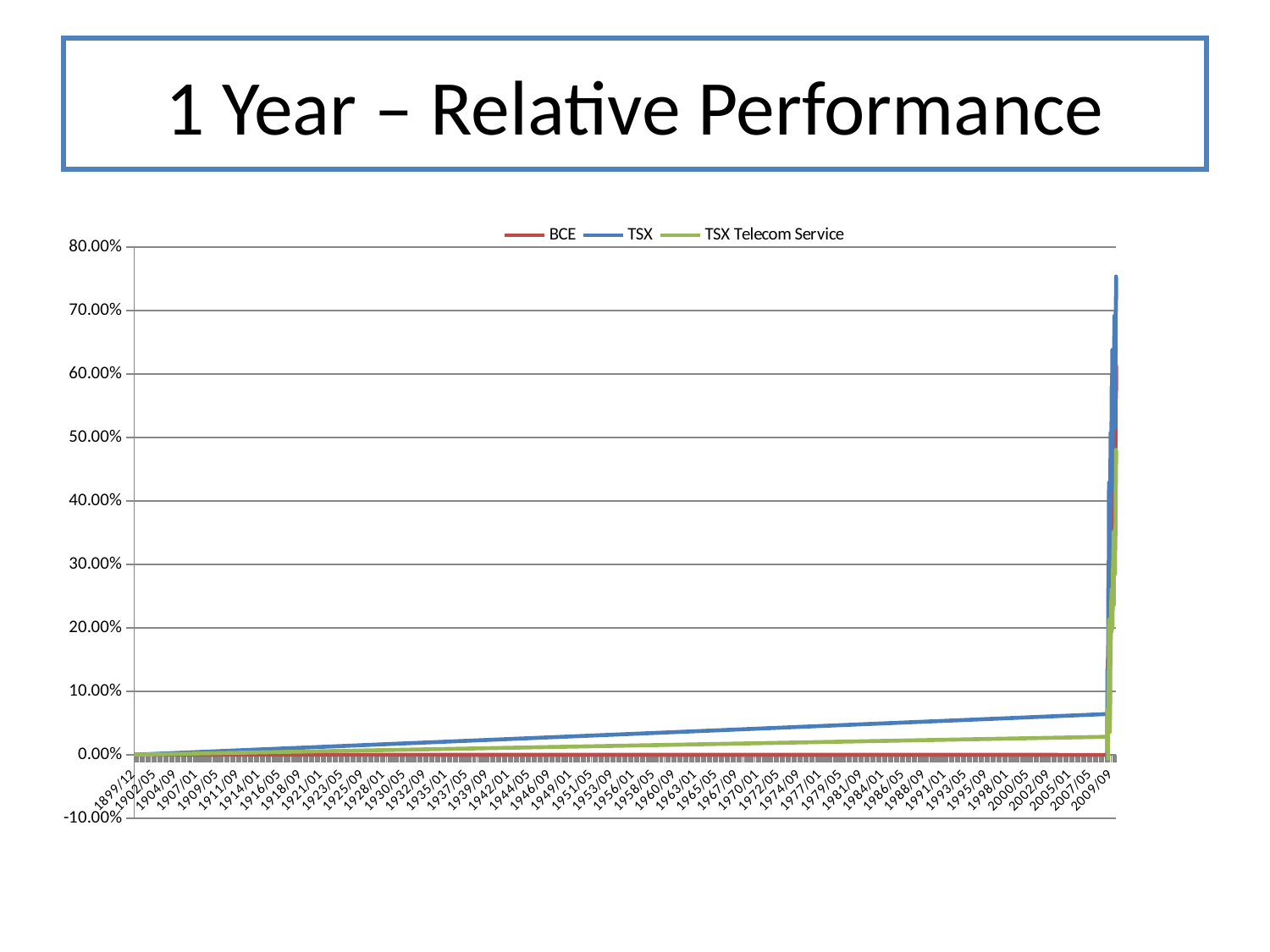
Is the peak value of the TSX Telecom Service series greater or less than 40.00%? greater Is the peak value of the TSX series greater or less than 70.00%? greater Is the peak value of the TSX Telecom Service series greater or less than 60.00%? less What is the lowest value shown on the vertical axis? -10.00% What is the highest value shown on the vertical axis? 80.00% How many series does the legend list? 3 Which series is drawn in blue? TSX Which series reaches the highest value on the chart? TSX What is the title of the slide's chart? 1 Year – Relative Performance Do the series values generally rise or fall moving from left to right along the x axis? rise What kind of chart is shown on the slide? line chart Which series reaches a higher peak value, TSX or TSX Telecom Service? TSX